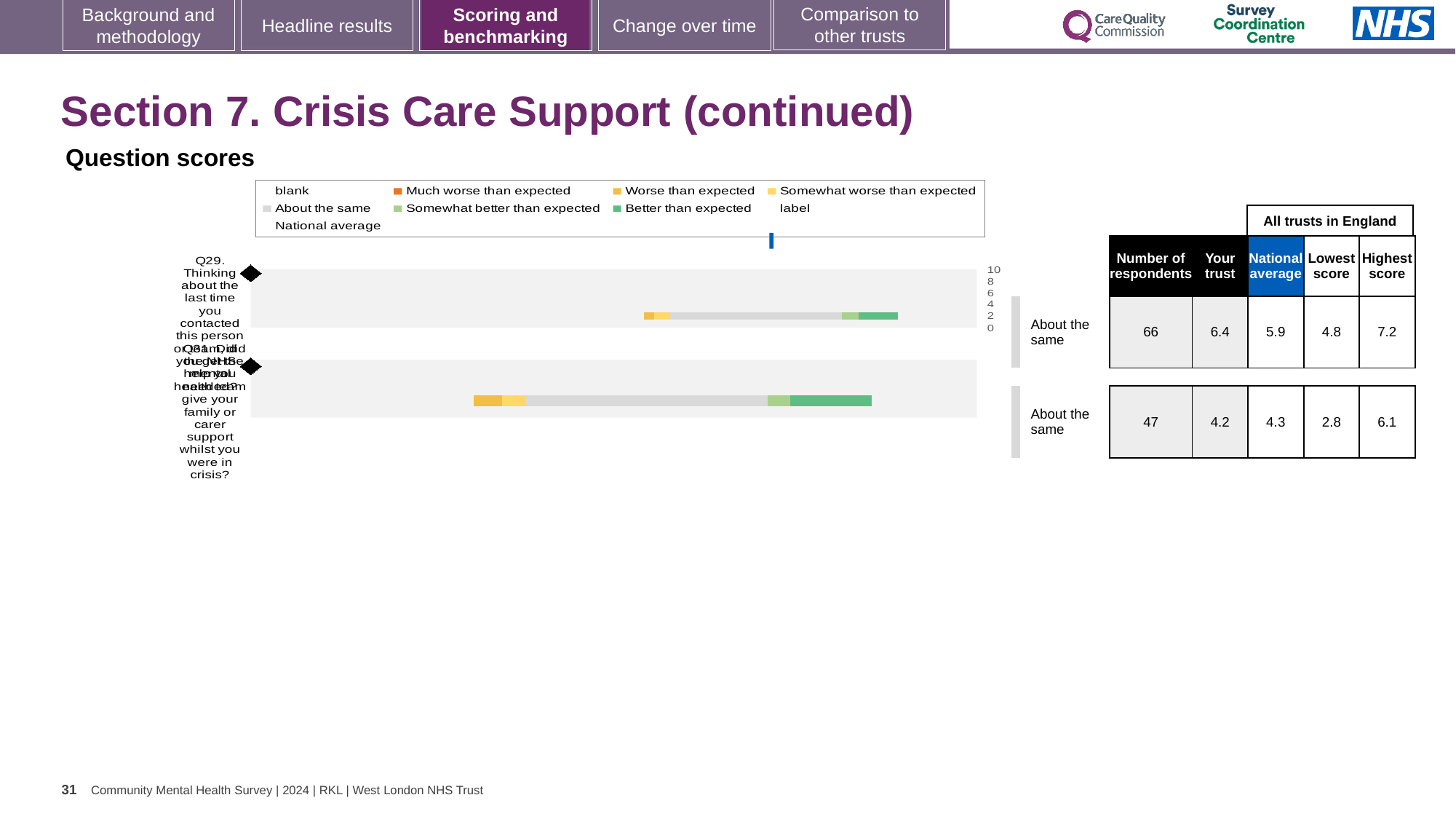
In the table beside the chart, what is the highest score for Q31? 6.1 What kind of chart is used to show the question scores on this slide? bar chart What is the difference between the highest score and the lowest score for Q29? 2.4 In the table beside the chart, what is the 'Your trust' score for Q31? 4.2 In the table beside the chart, what is the number of respondents for Q29? 66 How many questions (bars) are plotted in the question scores chart? 2 In the chart legend, what colour represents 'Much worse than expected'? orange What benchmark category is shown for Q31 next to the chart? About the same In the table beside the chart, what is the national average for Q29? 5.9 For Q29, which is larger: the 'Your trust' score or the national average? Your trust In the chart legend, what colour represents 'Better than expected'? green For Q31, which is larger: the 'Your trust' score or the national average? National average